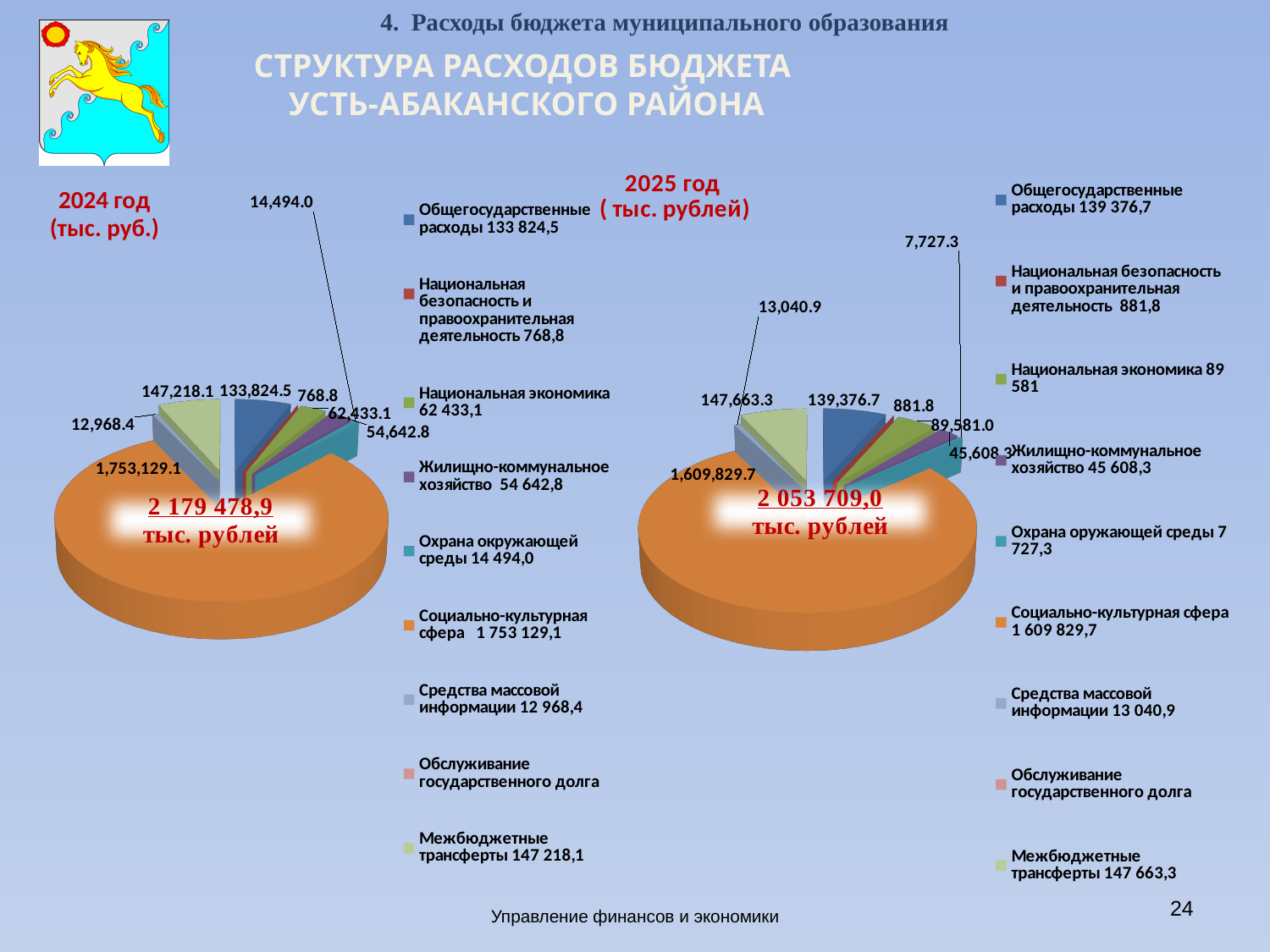
In the 2024 год chart, what is the value for Социально-культурная сфера? 1,753,129.1 Which is larger: Межбюджетные трансферты in the 2024 год chart or in the 2025 год chart? 2025 год How many entries does the legend of the 2025 год chart list? 9 What type of chart is used for the 2024 год budget structure? Pie chart In the 2025 год chart, what is the value for Национальная экономика? 89,581.0 In the 2024 год chart, which is larger: Национальная экономика or Жилищно-коммунальное хозяйство? Национальная экономика In the 2024 год chart, which category has the smallest labelled value? Национальная безопасность и правоохранительная деятельность In the 2025 год chart, what is the value for Жилищно-коммунальное хозяйство? 45,608.3 What is the difference between the Общегосударственные расходы values in the 2025 год chart and the 2024 год chart? 5,552.2 What total is printed on the 2025 год chart? 2 053 709,0 тыс. рублей In the 2024 год chart, what is the value for Охрана окружающей среды? 14,494.0 In the 2025 год chart, which category has the largest value? Социально-культурная сфера